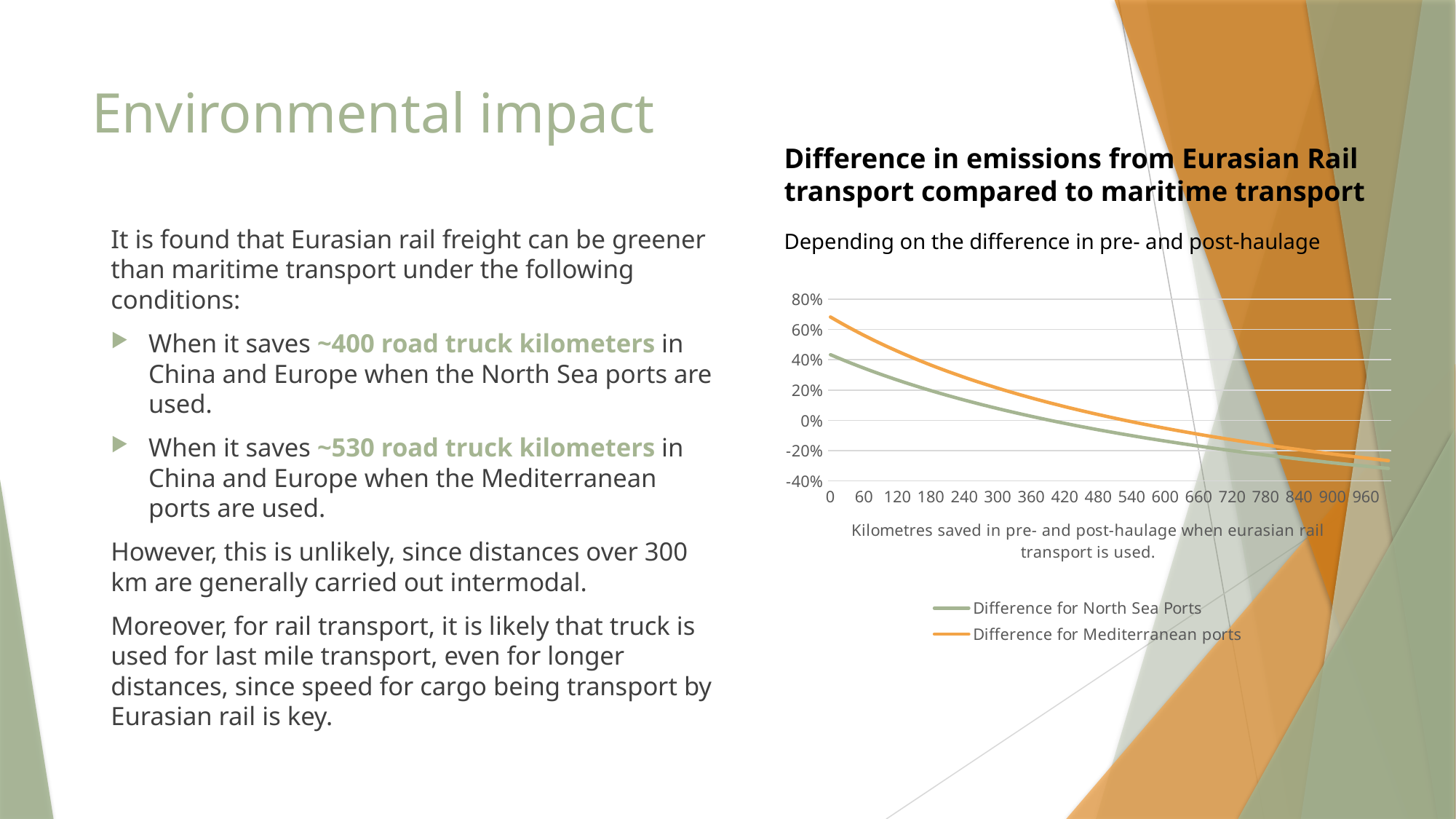
Do the values for North Sea Ports rise or fall as kilometres saved increase? fall What kind of chart is shown on the slide? line chart What is the title of the chart? Difference in emissions from Eurasian Rail transport compared to maritime transport How many tick labels are shown on the x axis? 17 Is the value for North Sea Ports at 0 kilometres saved greater or less than 20%? greater Is the value for Mediterranean ports at 0 kilometres saved greater or less than 60%? greater Is the value for Mediterranean ports at 960 kilometres saved greater or less than -40%? greater Do the values for Mediterranean ports rise or fall along the x axis? fall How many series does the chart legend list? 2 Which series is drawn in orange? Difference for Mediterranean ports At 0 kilometres saved, which series has the higher value: North Sea Ports or Mediterranean ports? Difference for Mediterranean ports